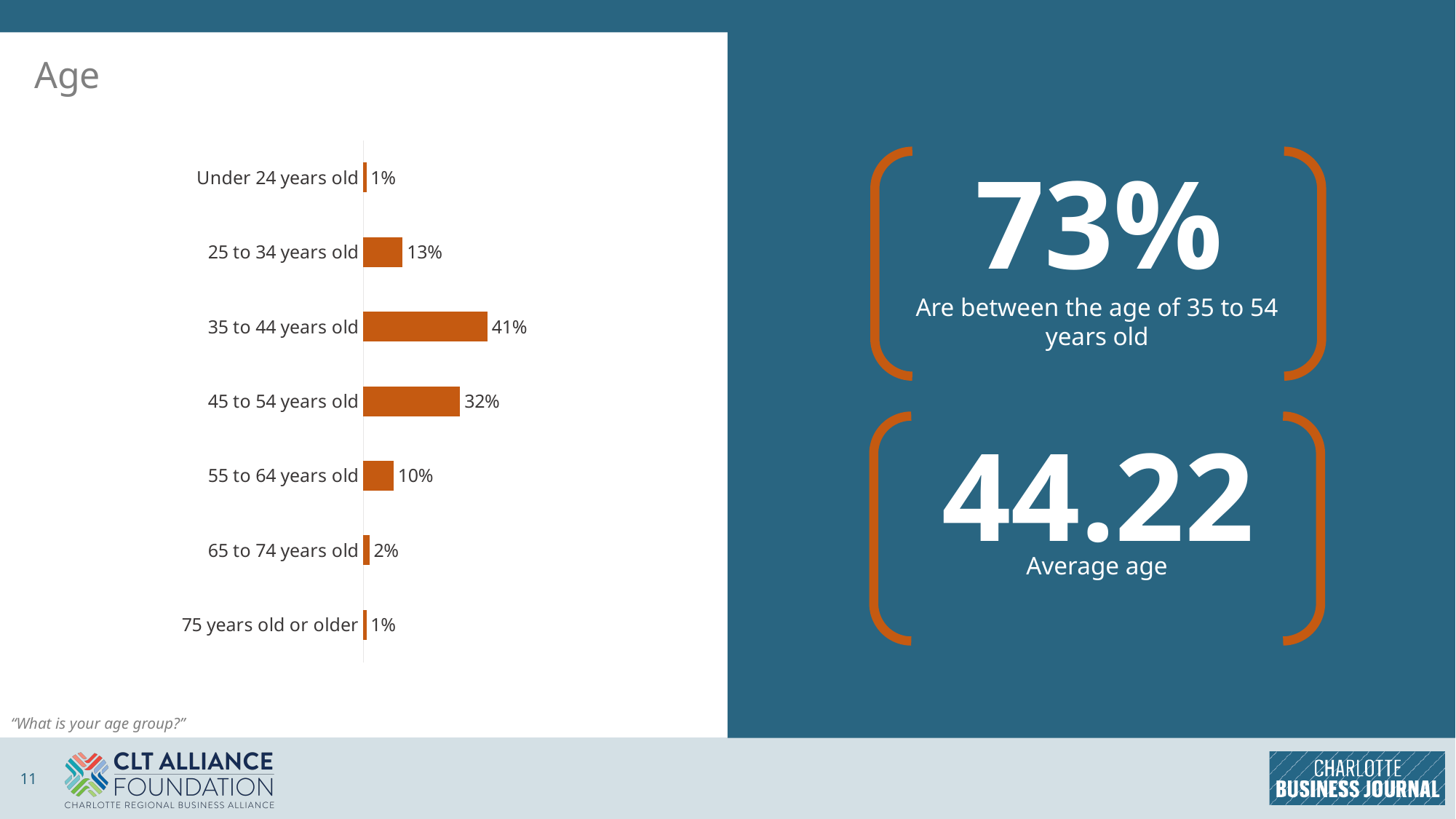
What percentage of respondents are 65 to 74 years old? 2% What survey question is the chart based on? "What is your age group?" What type of chart is used to show the age groups? Bar chart What is the average age shown on the slide? 44.22 Which group has a larger share: 25 to 34 years old or 55 to 64 years old? 25 to 34 years old What is the difference in percentage points between the 35 to 44 years old and 45 to 54 years old groups? 9 Which age group has the highest percentage of respondents? 35 to 44 years old What percentage of respondents are 25 to 34 years old? 13% What percentage of respondents are 55 to 64 years old? 10% How many age groups are shown in the chart? 7 What is the combined percentage of the 35 to 44 and 45 to 54 years old groups? 73% What percentage of respondents are 35 to 44 years old? 41%